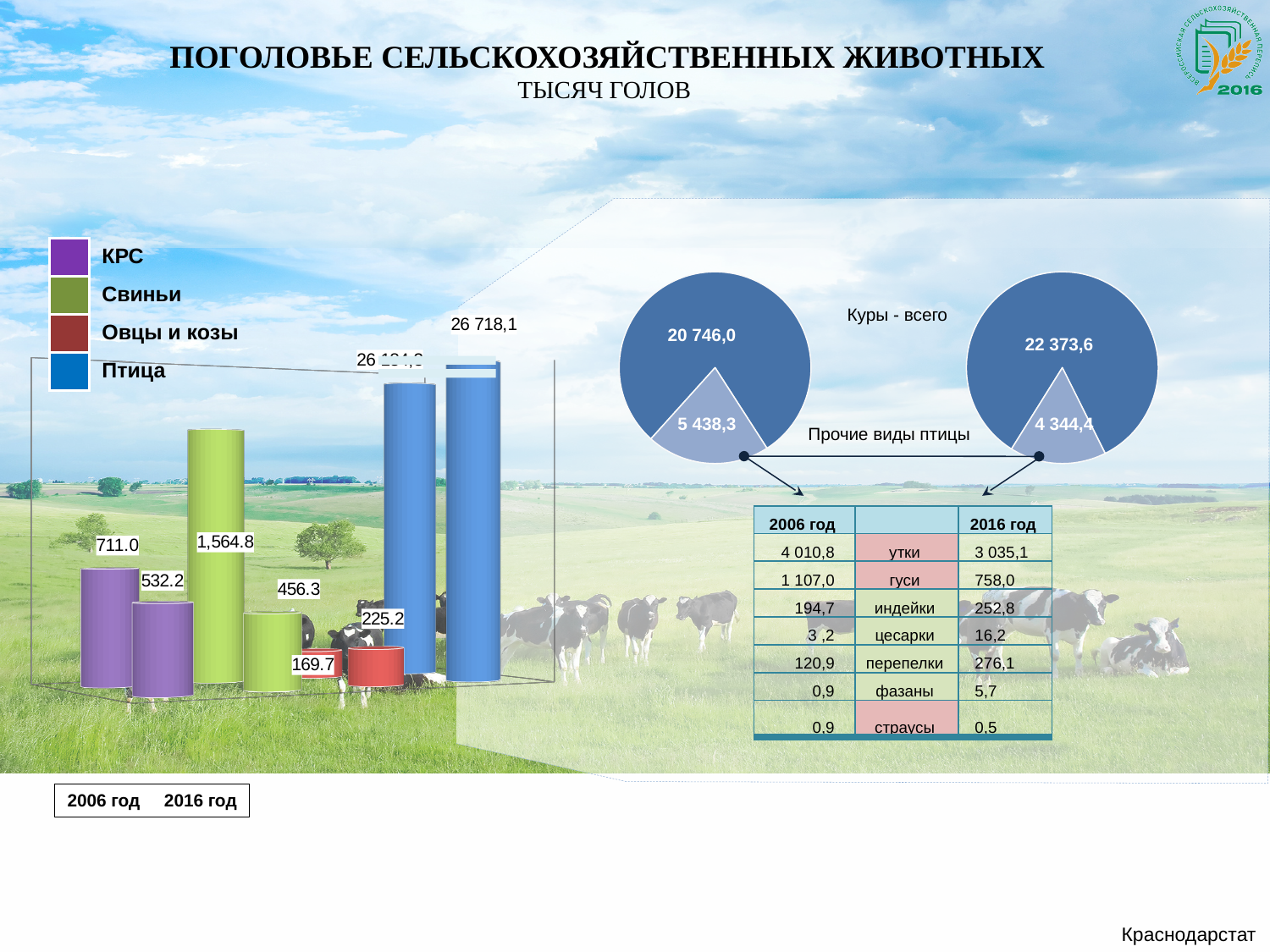
In the bar chart on the left, what is the value for Птица in 2016 год? 26 718,1 In the right pie chart (2016), what is the value of the Прочие виды птицы slice? 4 344,4 In the bar chart on the left, what is the difference between the КРС values for 2006 год and 2016 год? 178.8 In the bar chart on the left, what is the value for КРС in 2016 год? 532.2 In the left pie chart (2006), what is the value of the Куры - всего slice? 20 746,0 In the bar chart on the left, which is larger for Овцы и козы: the 2006 год value or the 2016 год value? 2016 год What kind of chart is the chart on the left of the slide? bar chart How many entries does the legend of the bar chart on the left list? 4 In the bar chart on the left, what is the value for КРС in 2006 год? 711.0 In the bar chart on the left, what is the value for Овцы и козы in 2016 год? 225.2 In the right pie chart (2016), which slice is larger: Куры - всего or Прочие виды птицы? Куры - всего In the bar chart on the left, what is the value for Свиньи in 2006 год? 1,564.8